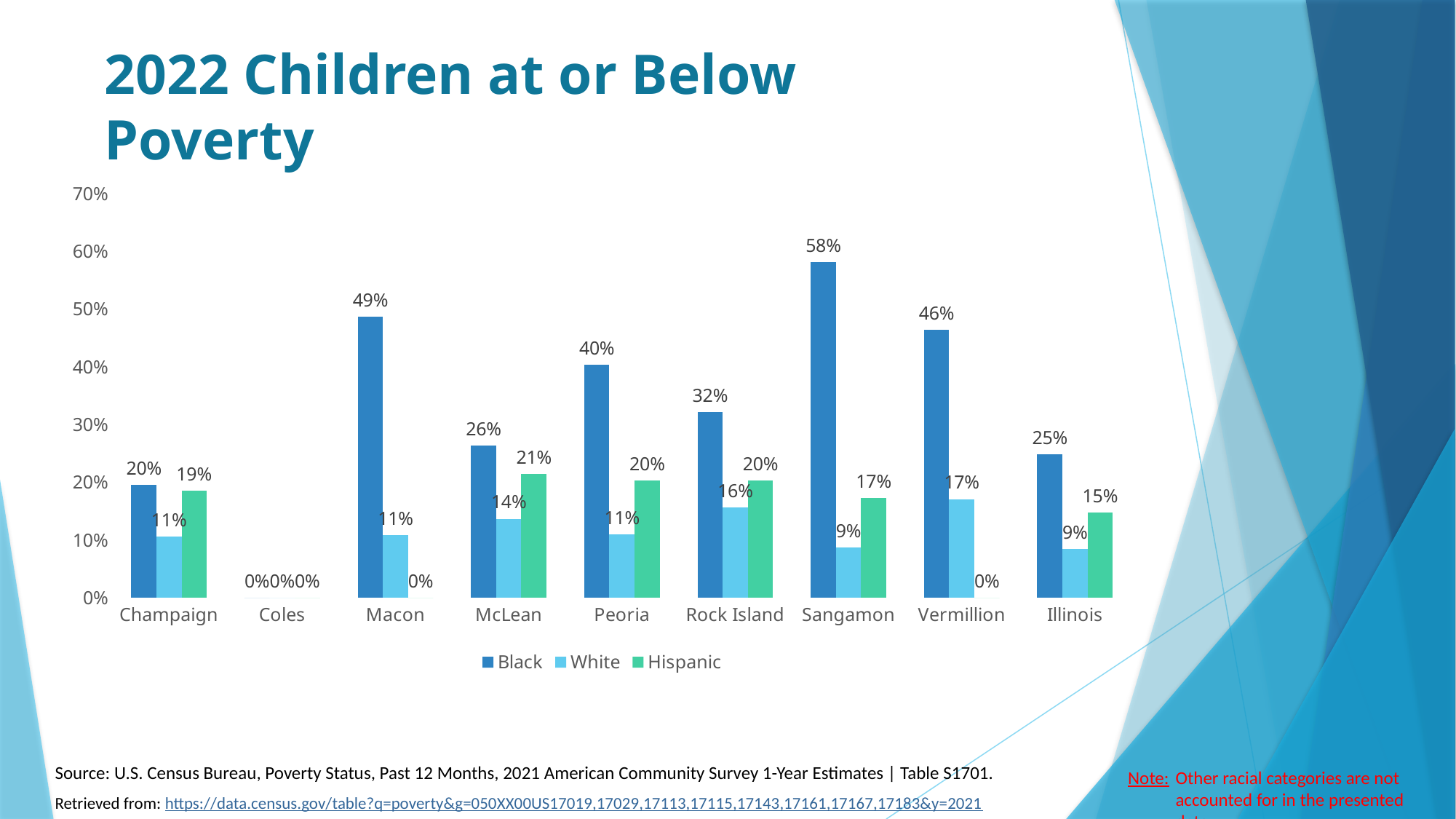
What is the value for Hispanic in McLean? 21% Which category has the highest value for the Black series? Sangamon Is the Black value for Vermillion greater or less than 40%? greater What is the title of the slide? 2022 Children at or Below Poverty What is the value for Black in Sangamon? 58% How many categories are shown on the x axis? 9 What is the value for White in Vermillion? 17% How many series does the legend list? 3 What is the difference between the Black and White values for Macon? 38% Which category has the lowest value for the Hispanic series, excluding the 0% values? Illinois Which is larger, the Black value for Peoria or the Black value for Rock Island? Peoria What kind of chart is shown on the slide? bar chart